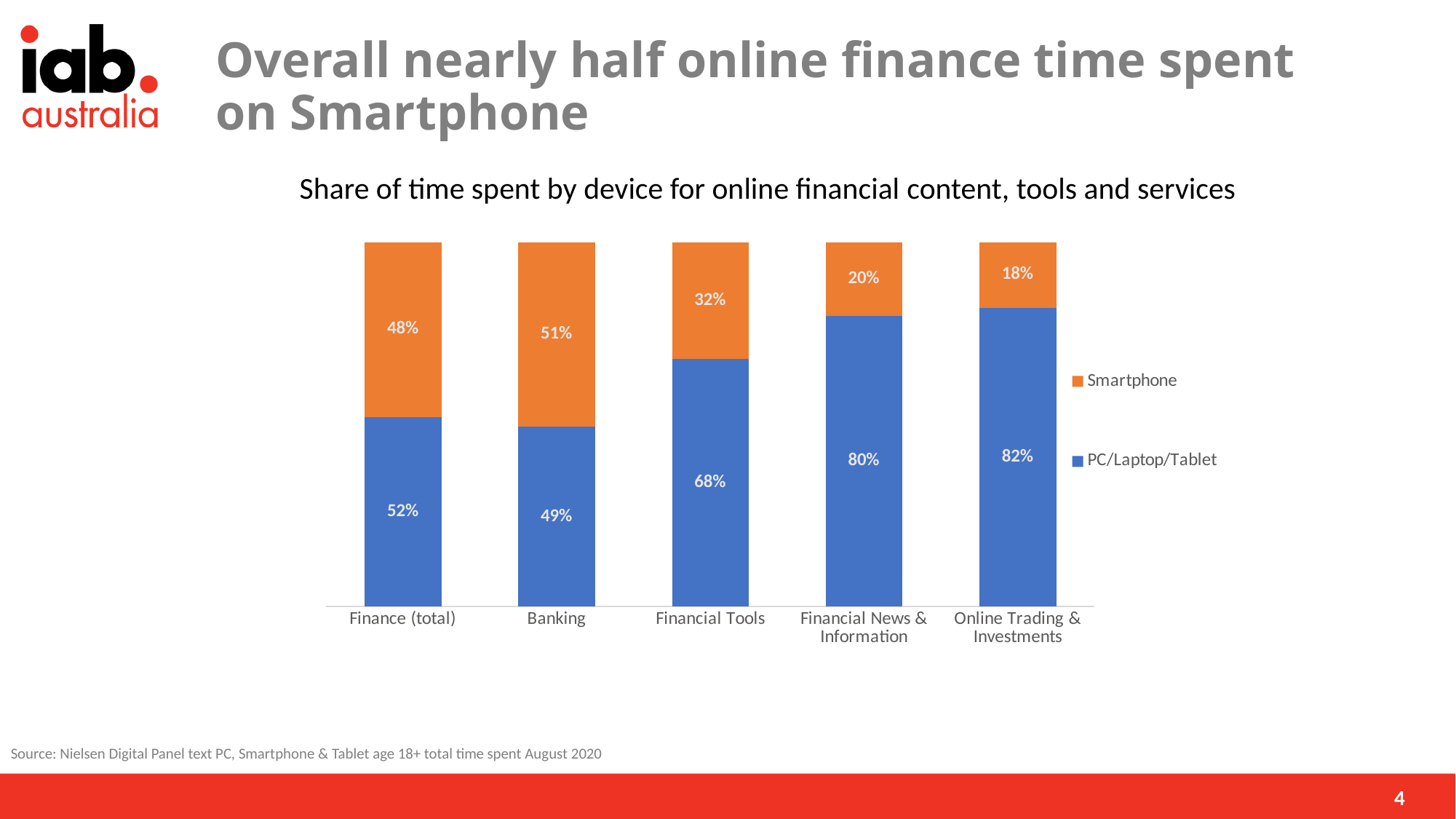
What is the difference between the PC/Laptop/Tablet share for Online Trading & Investments and for Financial News & Information? 2% How many categories are shown on the x axis? 5 How many series does the legend list? 2 What is the Smartphone share of time spent for Banking? 51% What kind of chart is shown on the slide? Stacked bar chart What is the PC/Laptop/Tablet share for Finance (total)? 52% Which colour represents Smartphone in the chart? Orange Which is larger: the Smartphone share for Financial Tools or for Financial News & Information? Financial Tools What is the Smartphone share for Online Trading & Investments? 18% Which category has the lowest PC/Laptop/Tablet share? Banking Which category has the highest Smartphone share? Banking What is the PC/Laptop/Tablet share of time spent for Financial Tools? 68%